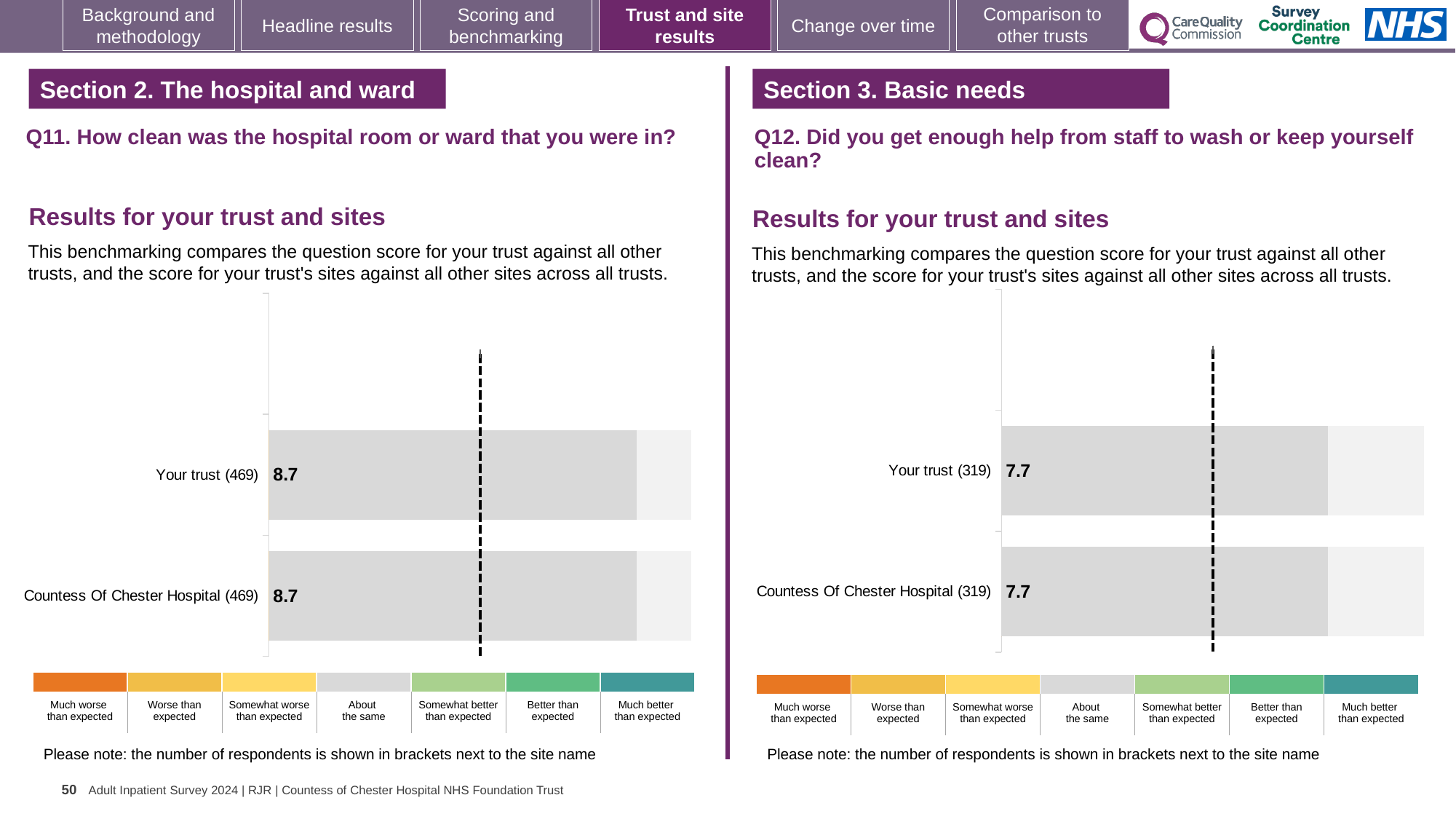
How many respondents are shown in brackets for Countess Of Chester Hospital on the Q11 chart (left)? 469 How many bars are plotted on the Q12 chart (right)? 2 On the Q11 chart (left), what is the difference between the score for Your trust and the score for Countess Of Chester Hospital? 0 What kind of chart is used for the Q11 results (left)? Bar chart How many bars are plotted on the Q11 chart (left)? 2 On the Q11 chart (left), which benchmark category does the grey colour of the bars correspond to in the legend? About the same On the Q11 chart (left), what is the score for Countess Of Chester Hospital (469)? 8.7 On the Q11 chart (left), what is the score for Your trust (469)? 8.7 On the Q12 chart (right), what is the score for Countess Of Chester Hospital (319)? 7.7 On the Q12 chart (right), what is the score for Your trust (319)? 7.7 How many respondents are shown in brackets for Your trust on the Q12 chart (right)? 319 On the Q12 chart (right), what is the difference between the score for Your trust and the score for Countess Of Chester Hospital? 0